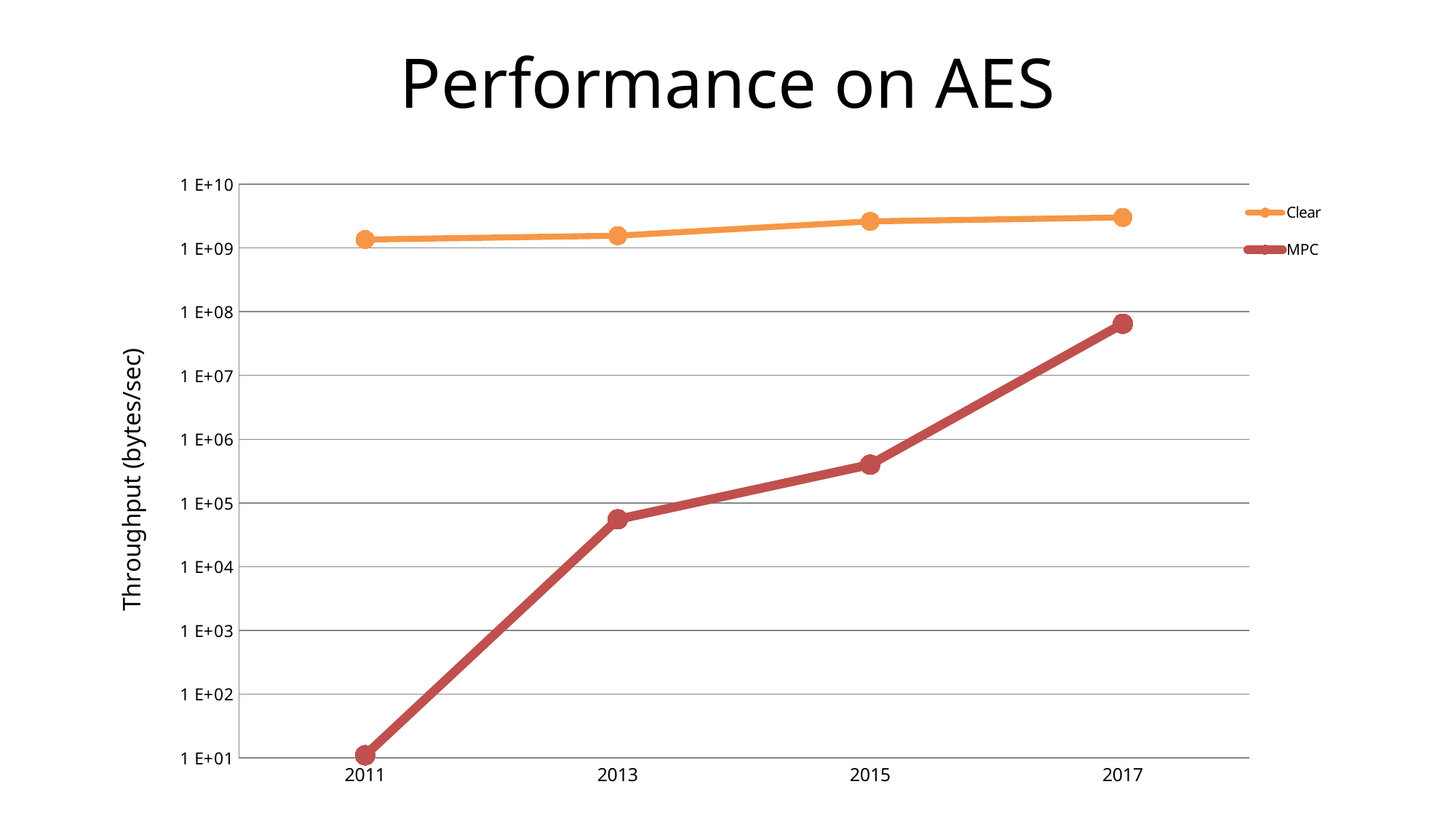
Is the MPC value for 2015 greater or less than 1 E+05? greater What is the label on the vertical axis? Throughput (bytes/sec) Is the Clear value for 2011 greater or less than 1 E+09? greater Is the MPC value for 2017 greater or less than 1 E+08? less How many series does the legend list? 2 What kind of chart is shown on the slide? line chart In 2017, which series has the higher throughput, Clear or MPC? Clear What are the names of the two series in the legend? Clear and MPC In which year is the MPC series at its lowest? 2011 In which year is the MPC series at its highest? 2017 How many years are plotted along the x axis? 4 Does the MPC series rise or fall from 2011 to 2017? rise